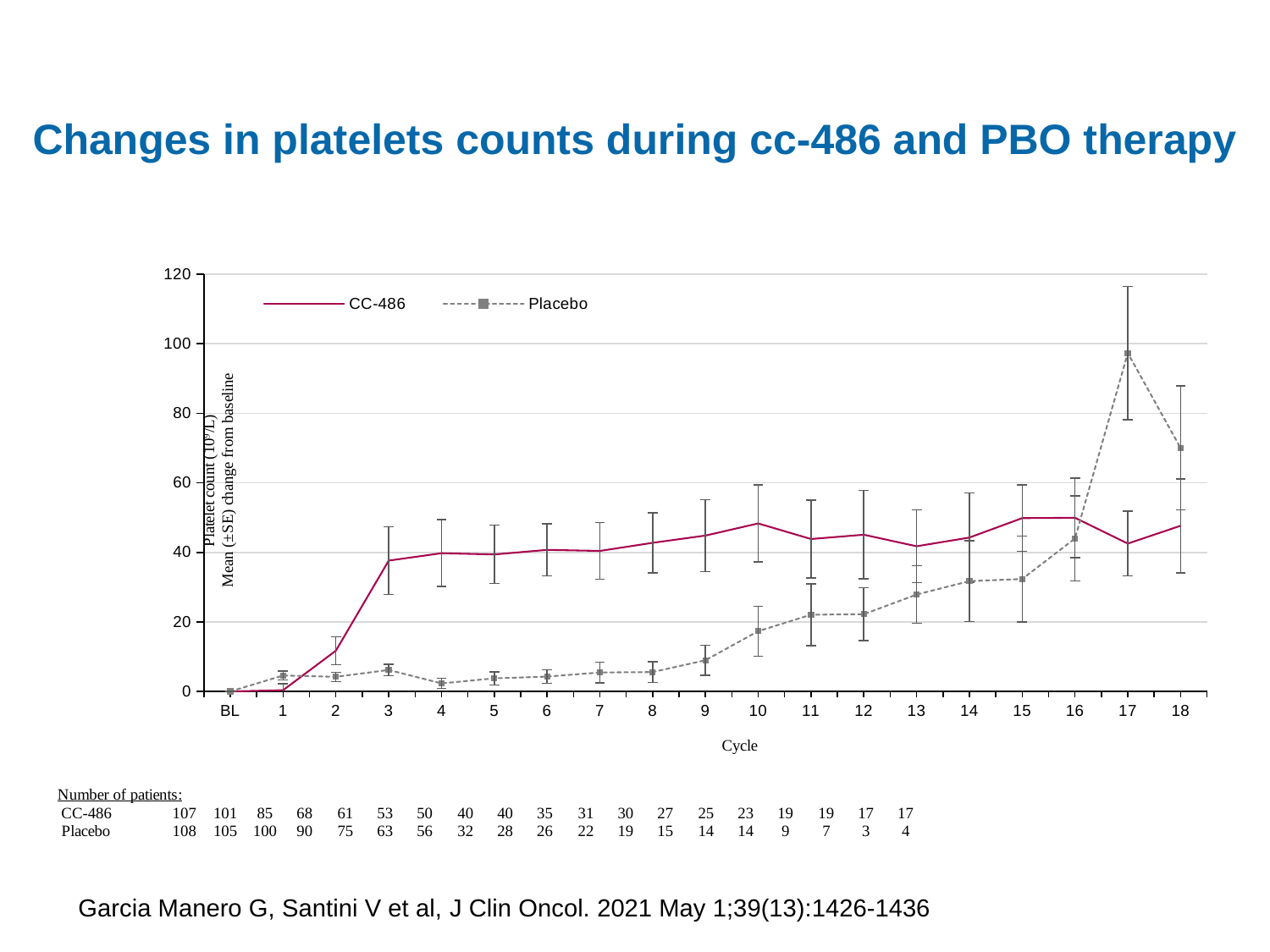
How many series does the legend list? 2 At cycle 17, which series has the higher value, CC-486 or Placebo? Placebo Is the Placebo value at cycle 18 greater or less than 60? greater Is the Placebo value at cycle 5 greater or less than 20? less What is the label of the x axis? Cycle At which cycle does the Placebo series reach its highest value? 17 Is the Placebo value at cycle 17 greater or less than 80? greater At cycle 10, which series has the higher value, CC-486 or Placebo? CC-486 What kind of chart is shown on the slide? Line chart How many points are labelled along the x axis (including BL)? 19 What are the two series named in the legend? CC-486 and Placebo